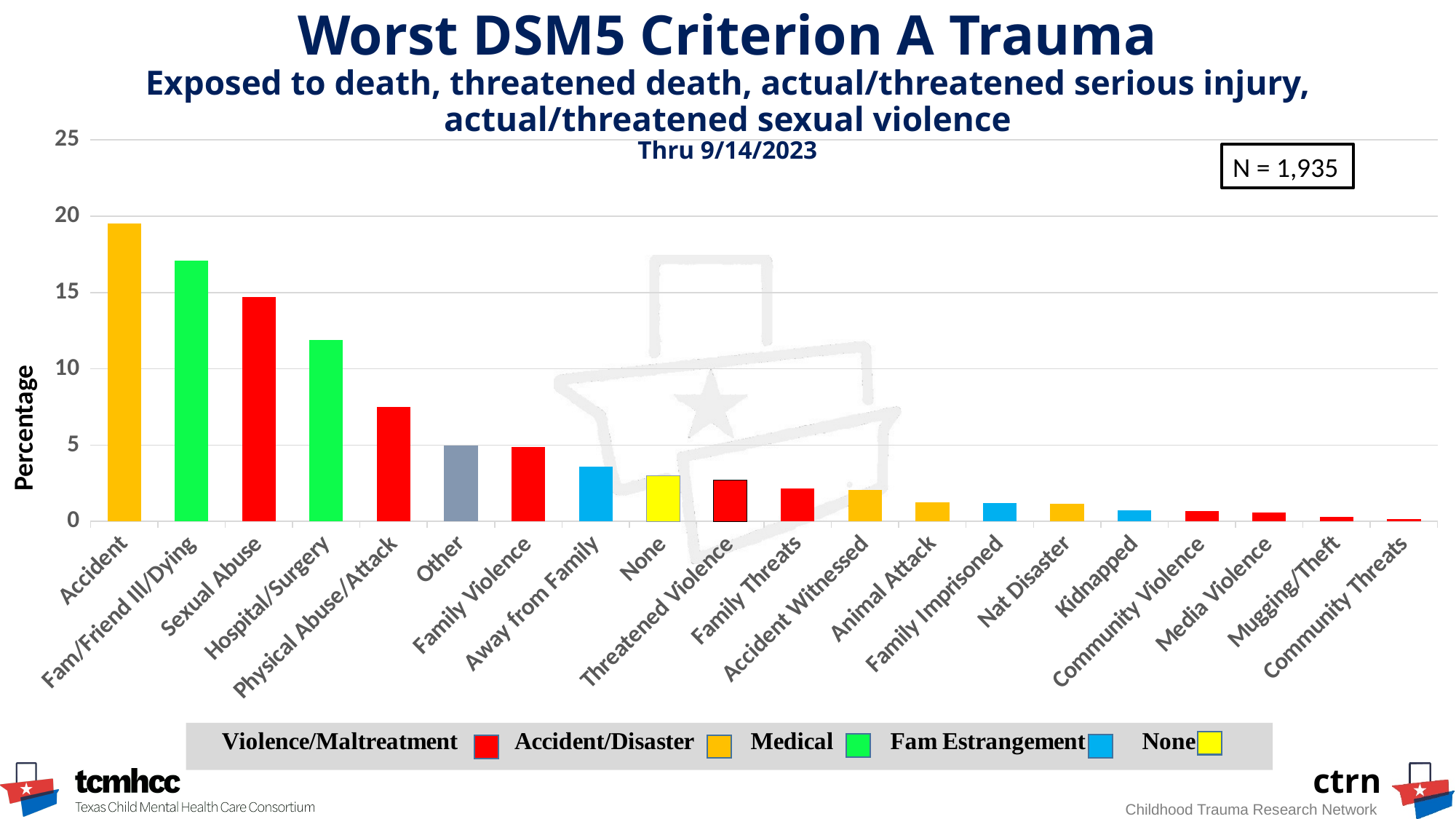
Which trauma category has the lowest percentage? Community Threats Which trauma category has the highest percentage? Accident What kind of chart is shown on the slide? Bar chart What sample size (N) is shown on the slide? N = 1,935 How many trauma categories are plotted on the x axis? 20 How many entries does the legend list? 5 Which has a higher percentage, Hospital/Surgery or Physical Abuse/Attack? Hospital/Surgery Is the value for Accident greater or less than 15? greater Do the bar values rise or fall moving from left to right along the x axis? Fall Which has a higher percentage, Accident or Sexual Abuse? Accident Is the value for Hospital/Surgery greater or less than 10? greater Is the value for Physical Abuse/Attack greater or less than 10? less